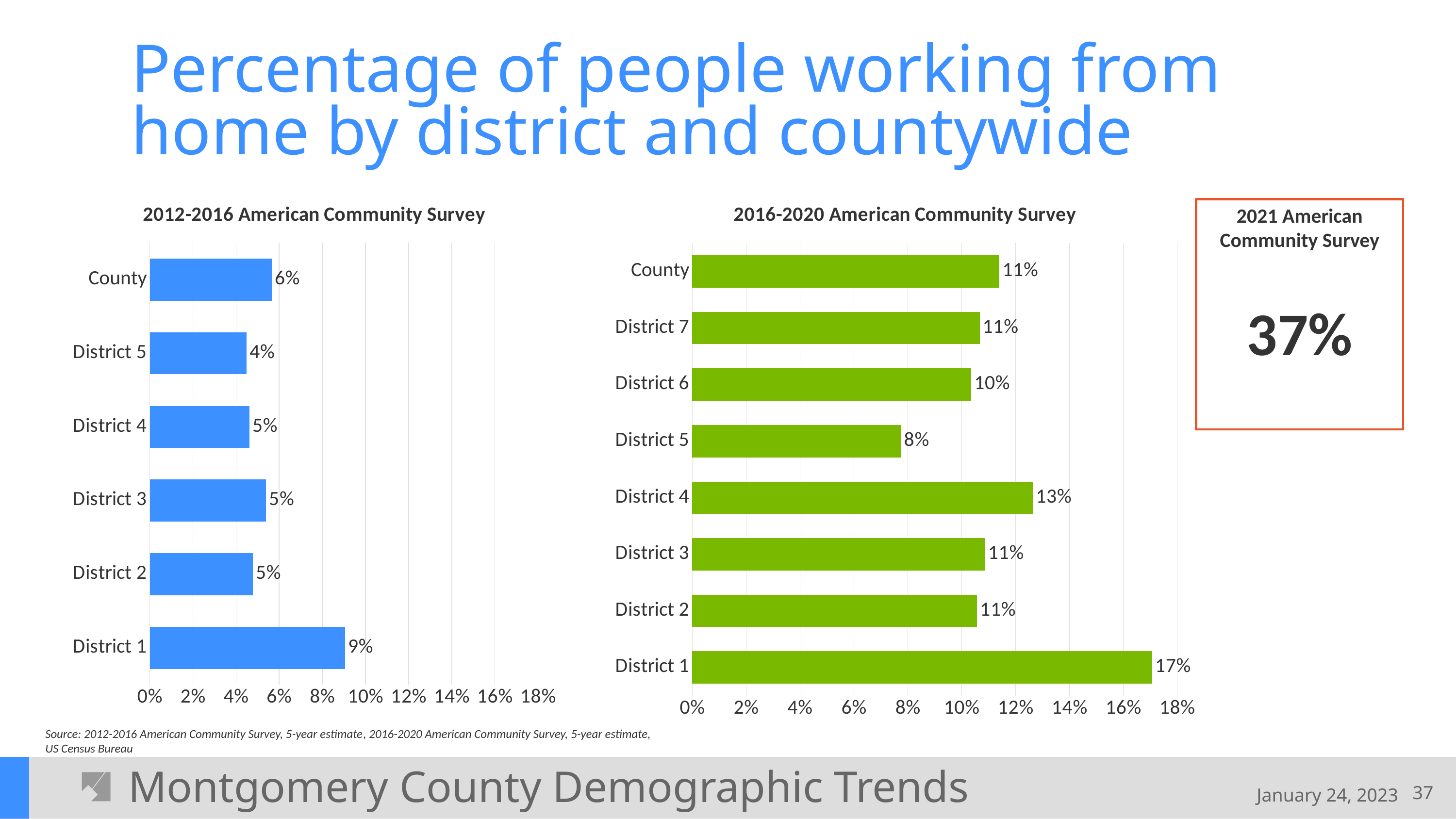
In the 2012-2016 American Community Survey chart, which category has the lowest value? District 5 In the 2016-2020 American Community Survey chart, what is the value for County? 11% In the 2016-2020 American Community Survey chart, which category has the highest value? District 1 In the 2016-2020 American Community Survey chart, which category has the lowest value? District 5 In the 2012-2016 American Community Survey chart, which category has the highest value? District 1 How many categories are shown in the 2012-2016 American Community Survey chart? 6 How many categories are shown in the 2016-2020 American Community Survey chart? 8 In the 2016-2020 American Community Survey chart, what is the value for District 4? 13% In the 2012-2016 American Community Survey chart, what is the value for District 1? 9% In the 2016-2020 American Community Survey chart, which is larger, District 4 or District 6? District 4 In the 2016-2020 American Community Survey chart, what is the difference between District 1 and District 5? 9% What kind of chart is the 2012-2016 American Community Survey chart? Bar chart